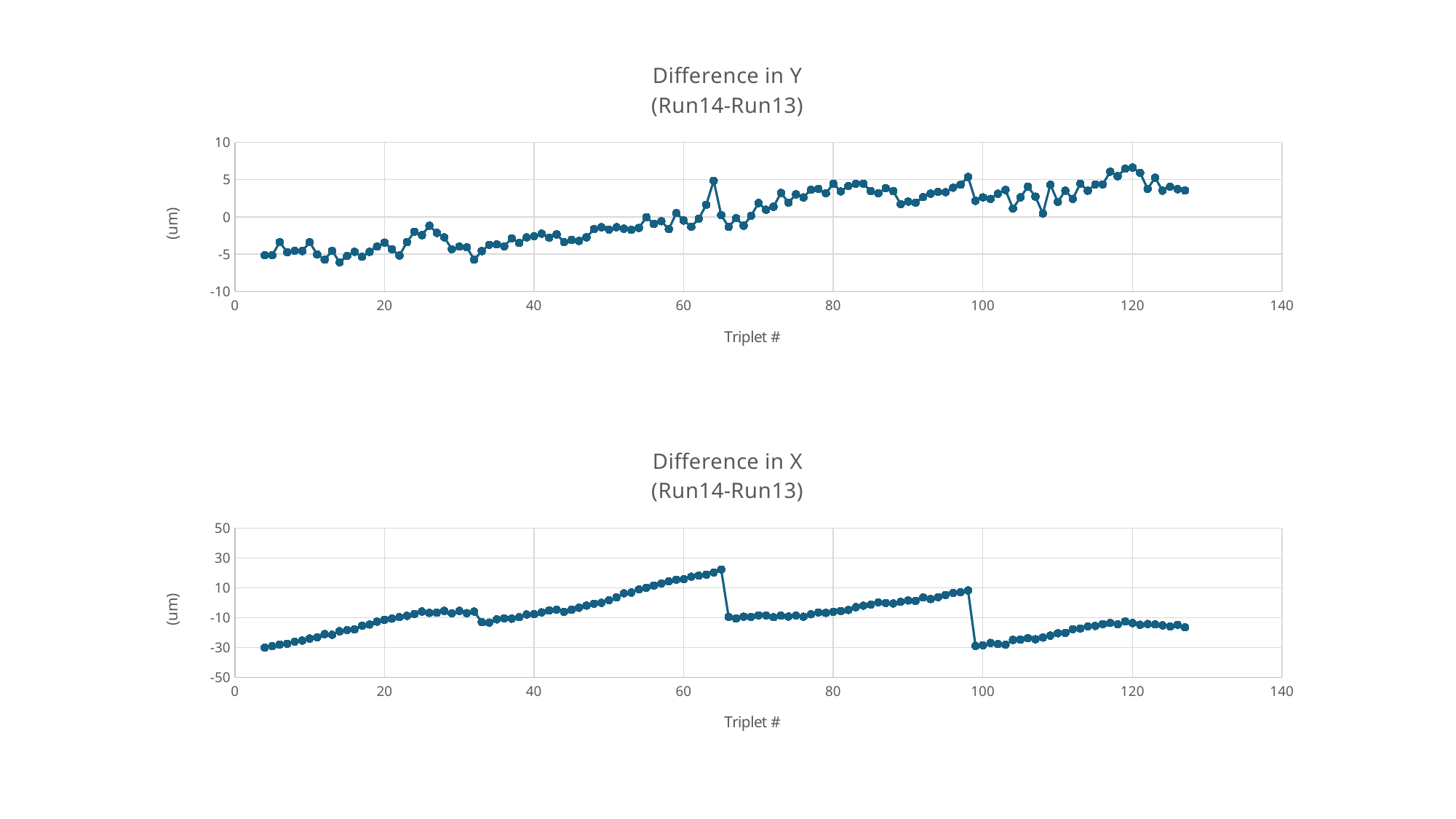
In the "Difference in X (Run14-Run13)" chart, which is larger: the value at triplet 64 or the value at triplet 66? triplet 64 In the "Difference in X (Run14-Run13)" chart, is the value at the first plotted triplet (around triplet 4) greater or less than -10? less In the "Difference in X (Run14-Run13)" chart, is the value at triplet 64 greater or less than 10? greater In the "Difference in X (Run14-Run13)" chart, is the value at triplet 100 greater or less than -10? less In the "Difference in X (Run14-Run13)" chart, do the values rise or fall between triplet 4 and triplet 64? rise In the "Difference in Y (Run14-Run13)" chart, which is larger: the value at triplet 4 or the value at triplet 120? triplet 120 What kind of chart is the "Difference in Y (Run14-Run13)" chart? line chart What is the y-axis label on the "Difference in Y (Run14-Run13)" chart? (um) In the "Difference in Y (Run14-Run13)" chart, do the values generally rise or fall from left to right along the x axis? rise What is the x-axis label on the "Difference in X (Run14-Run13)" chart? Triplet #